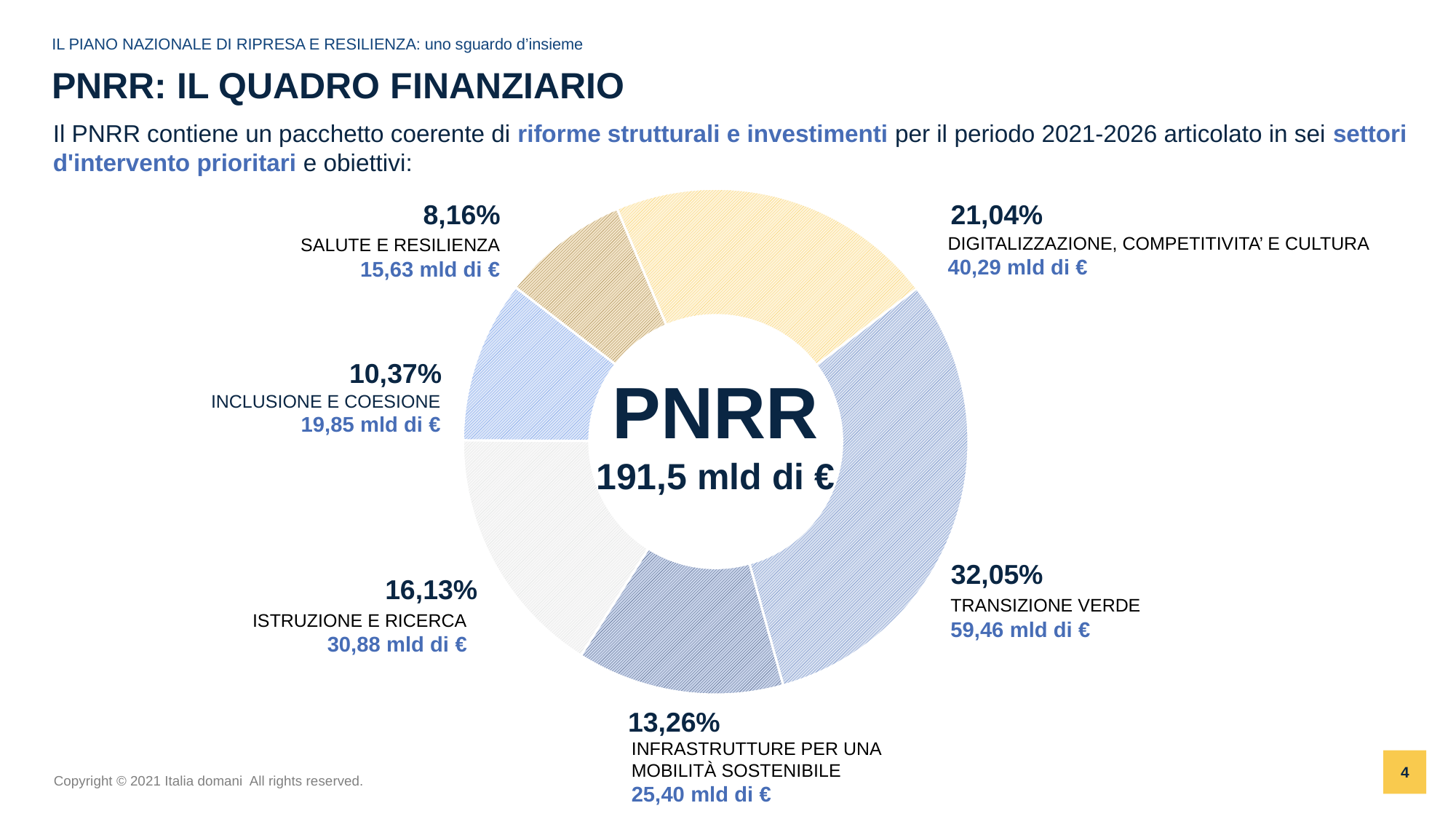
What kind of chart is used to show the PNRR financial breakdown? Donut (pie) chart What is the difference in percentage points between Transizione Verde and Digitalizzazione, Competitività e Cultura? 11,01% How many sectors are shown in the PNRR donut chart? 6 What is the total amount shown in the centre of the PNRR chart? 191,5 mld di € What is the difference in mld di € between Transizione Verde and Digitalizzazione, Competitività e Cultura? 19,17 mld di € What text is written in the centre of the donut chart above the total amount? PNRR Which sector has the largest share of the PNRR chart? Transizione Verde What share of the PNRR donut chart is Transizione Verde? 32,05% What percentage of the PNRR is allocated to Inclusione e Coesione? 10,37% Which sector has the smallest share of the PNRR chart? Salute e Resilienza Which is larger: the share for Istruzione e Ricerca or the share for Infrastrutture per una Mobilità Sostenibile? Istruzione e Ricerca How many mld di € are allocated to Digitalizzazione, Competitività e Cultura? 40,29 mld di €